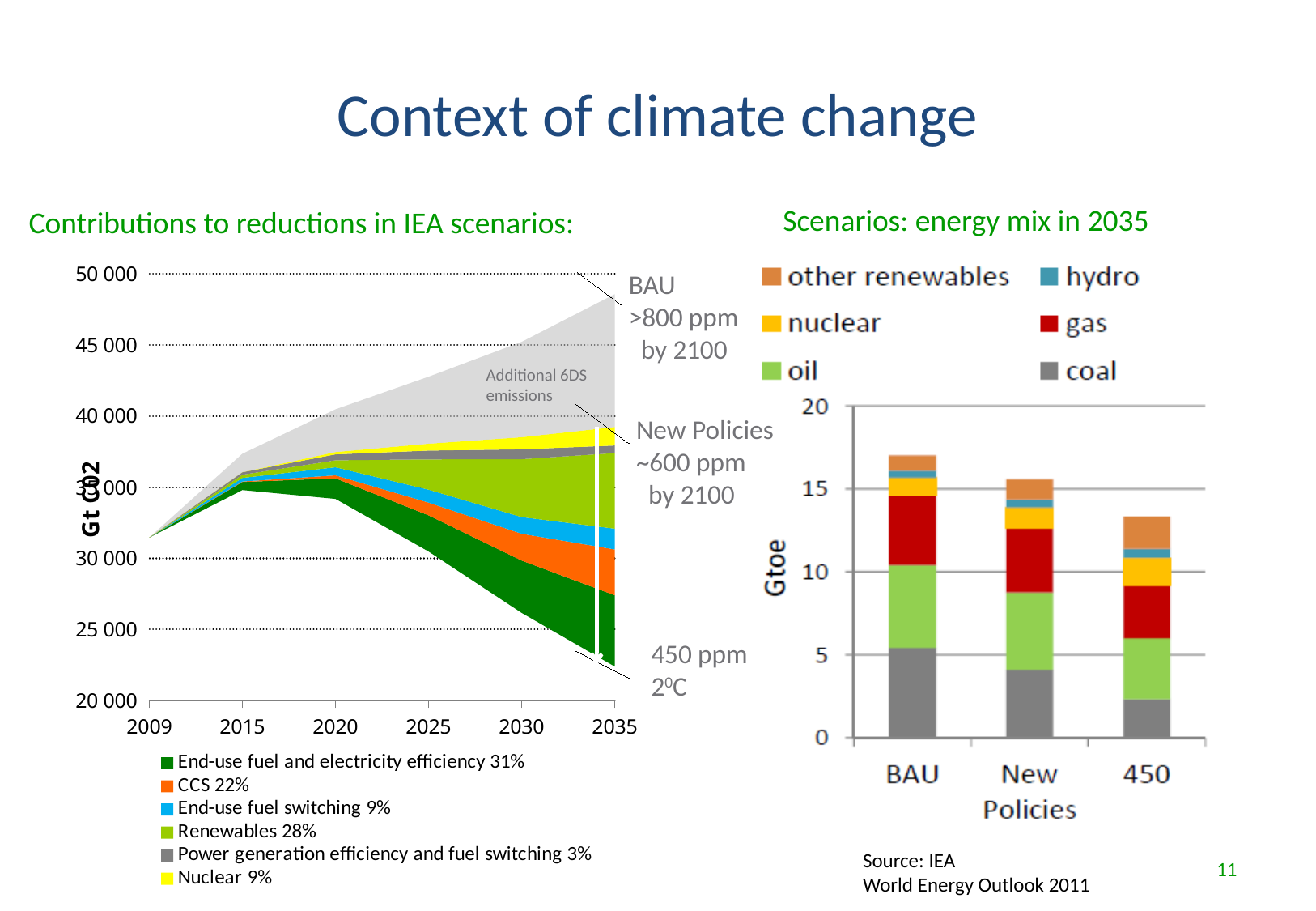
On the left chart 'Contributions to reductions in IEA scenarios', what percentage is given for CCS in the legend? 22% On the left chart 'Contributions to reductions in IEA scenarios', which contribution has the lowest percentage in the legend? Power generation efficiency and fuel switching 3% On the left chart 'Contributions to reductions in IEA scenarios', what kind of chart is it? Stacked area chart On the right chart 'Scenarios: energy mix in 2035', what kind of chart is it? Stacked bar chart On the left chart 'Contributions to reductions in IEA scenarios', is the 450 ppm value in 2035 greater or less than 25 000? less On the left chart 'Contributions to reductions in IEA scenarios', how many series does the legend list? 6 On the right chart 'Scenarios: energy mix in 2035', how many scenarios are shown on the x axis? 3 On the left chart 'Contributions to reductions in IEA scenarios', which contribution has the highest percentage in the legend? End-use fuel and electricity efficiency 31% On the right chart 'Scenarios: energy mix in 2035', how many series does the legend list? 6 On the left chart 'Contributions to reductions in IEA scenarios', is the BAU value in 2035 greater or less than 45 000? greater On the right chart 'Scenarios: energy mix in 2035', is the coal value for the 450 scenario greater or less than 5? less On the right chart 'Scenarios: energy mix in 2035', which scenario has the highest total bar? BAU